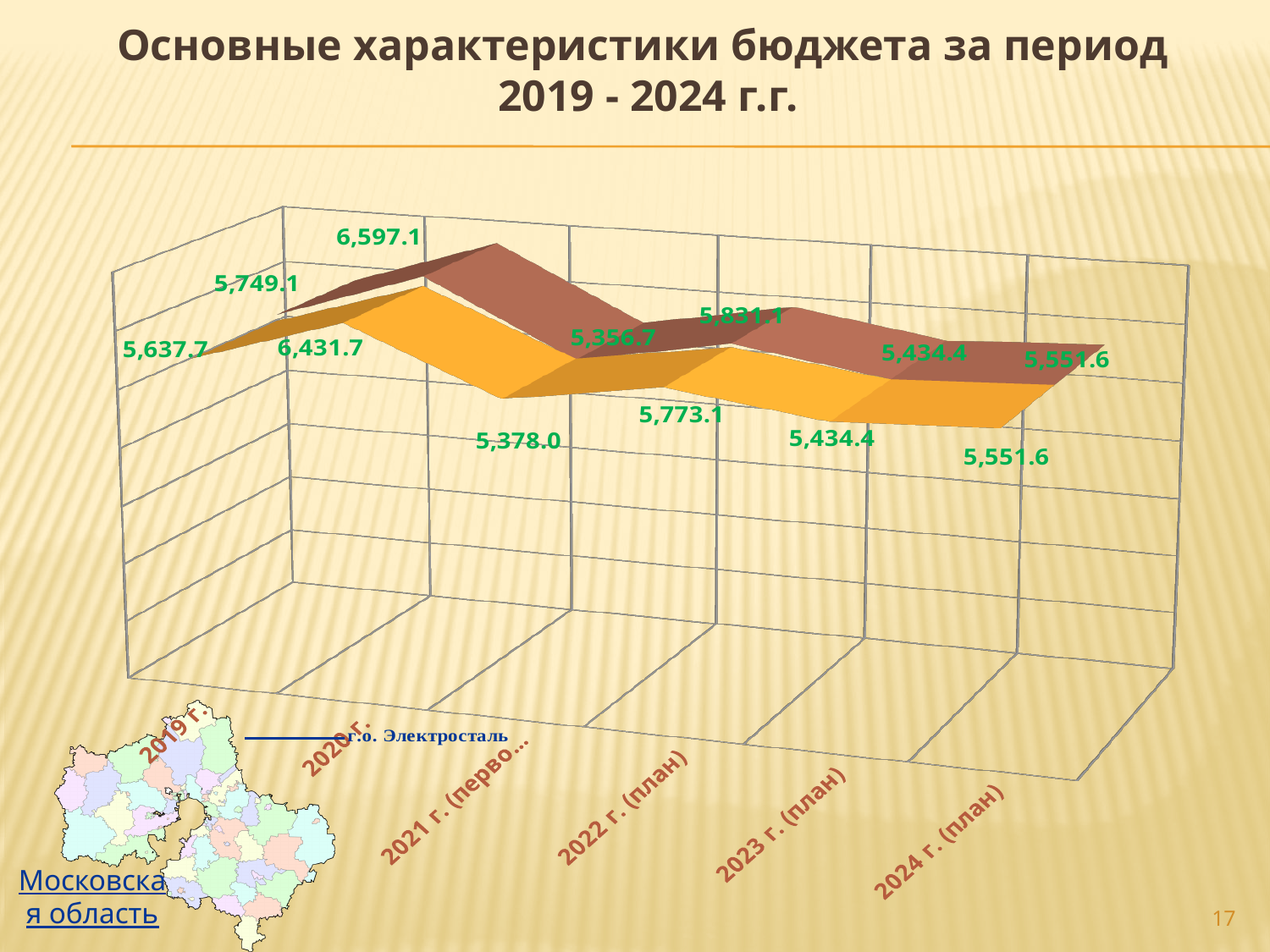
What kind of chart is shown on the slide? 3D line chart How many categories (years) are shown along the x axis of the chart? 6 In which year does the brown (back) series have its lowest value? 2021 г. What is the title of the slide containing the chart? Основные характеристики бюджета за период 2019 - 2024 г.г. What is the difference between the brown series and the orange series in 2020 г.? 165.4 Does the orange (front) series rise or fall from 2020 г. to 2021 г.? fall What is the value of the orange (front) series for 2019 г.? 5,637.7 What is the value of the orange (front) series for 2020 г.? 6,431.7 In which year does the orange (front) series reach its highest value? 2020 г. What is the value of the brown (back) series for 2020 г.? 6,597.1 What is the value of the brown (back) series for 2022 г. (план)? 5,831.1 For the orange (front) series, which is larger: the value for 2022 г. (план) or for 2023 г. (план)? 2022 г. (план)